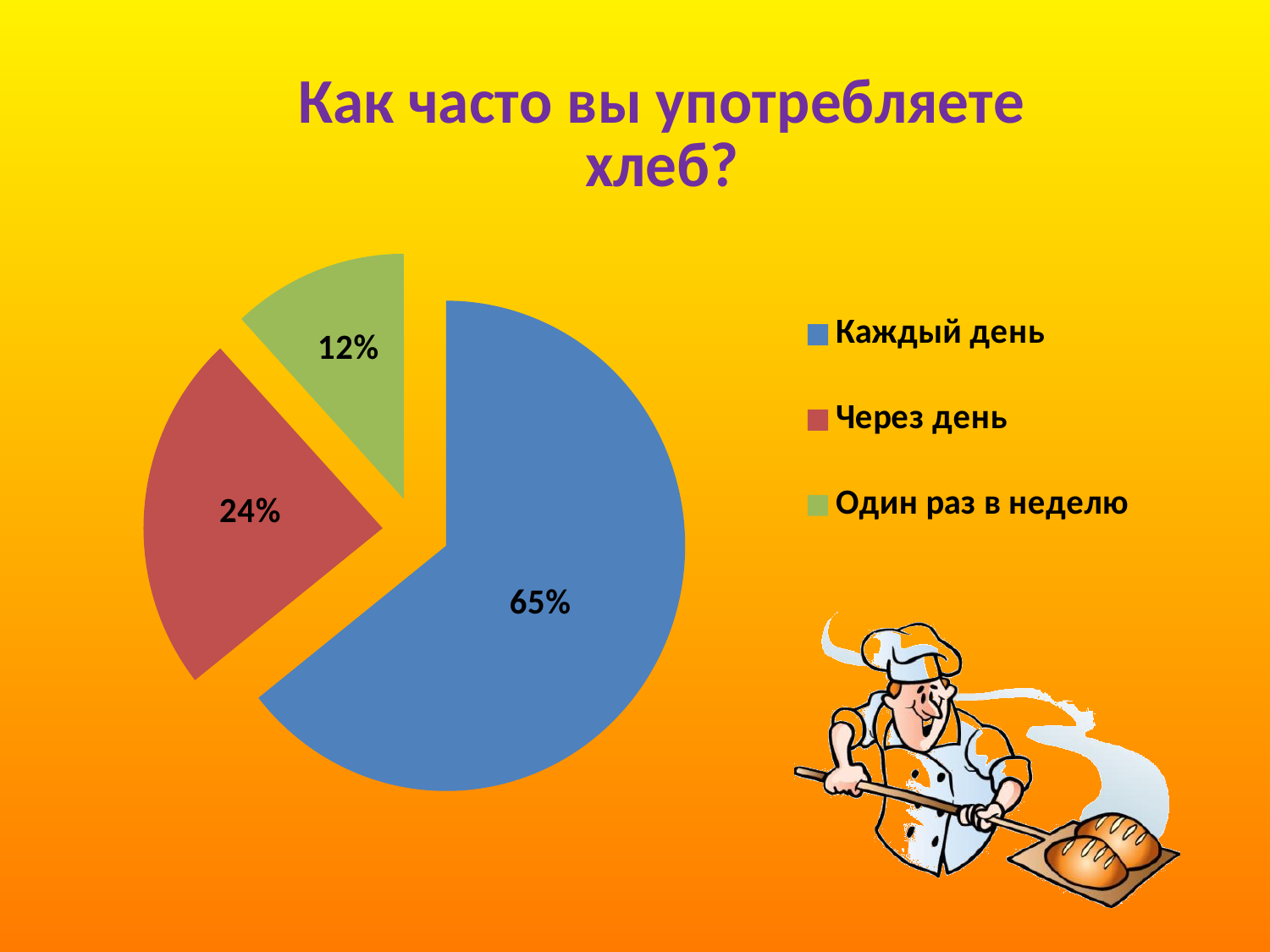
What kind of chart is shown on the slide? Pie chart What percentage of respondents answered "Каждый день"? 65% What is the title of the chart? Как часто вы употребляете хлеб? Which category has the largest share of the pie? Каждый день What is the difference in percentage points between "Каждый день" and "Через день"? 41 Which category has the smallest share of the pie? Один раз в неделю Which is larger: the share for "Через день" or for "Один раз в неделю"? Через день How many slices does the pie chart have? 3 What is the difference in percentage points between "Через день" and "Один раз в неделю"? 12 What percentage of respondents answered "Через день"? 24% What colour is the slice for "Через день"? Red What percentage of respondents answered "Один раз в неделю"? 12%